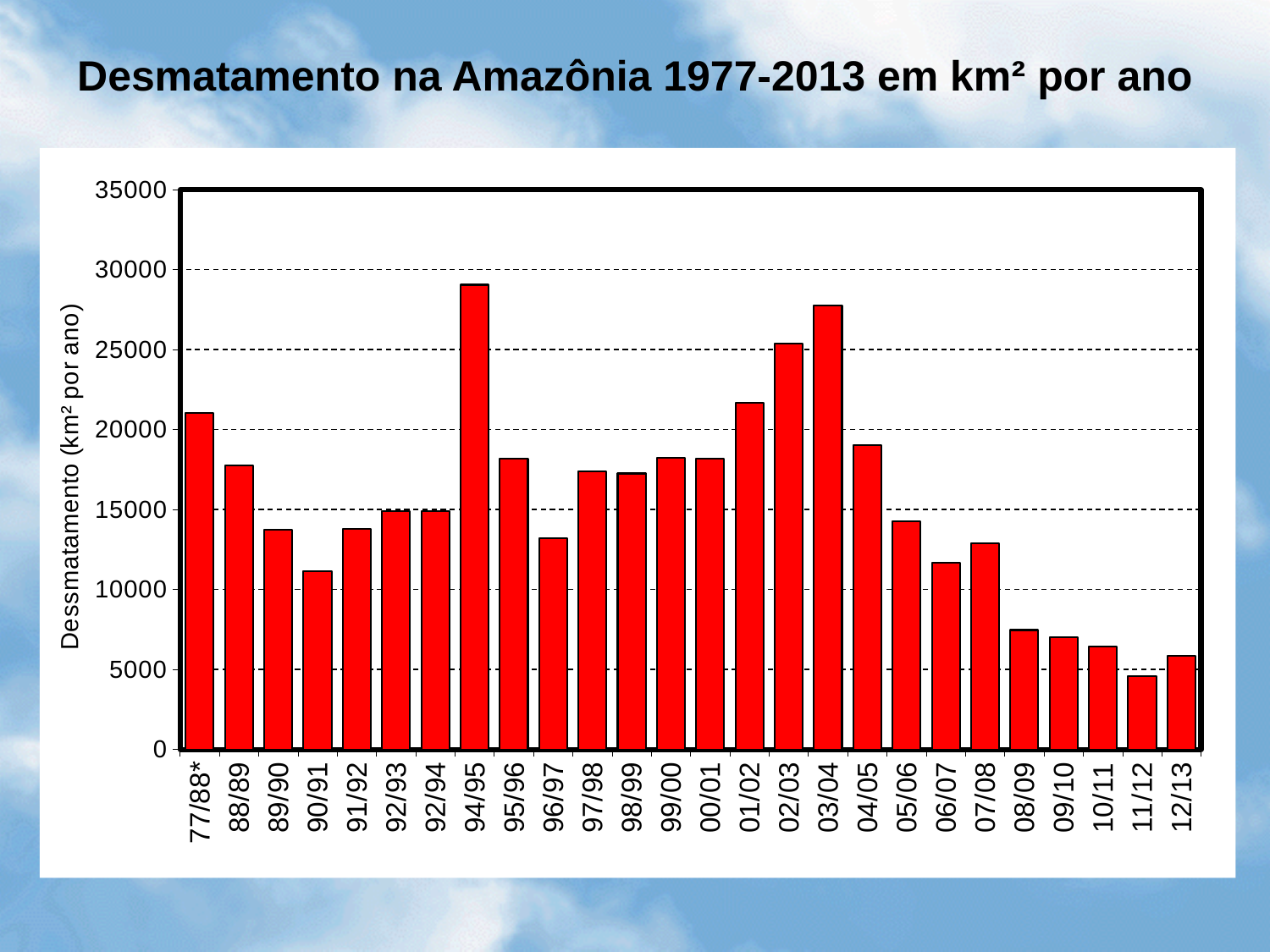
Do the values generally rise or fall from 04/05 to 11/12? fall Which period has the highest deforestation value? 94/95 What is the label on the vertical axis of the chart? Dessmatamento (km² por ano) What kind of chart is shown on the slide? bar chart Which period has the lowest deforestation value? 11/12 How many bars (periods) are plotted in the chart? 26 Which is larger, the value for 94/95 or the value for 03/04? 94/95 Is the value for 77/88* greater or less than 20000? greater Is the value for 11/12 greater or less than 5000? less Is the value for 08/09 greater or less than 10000? less